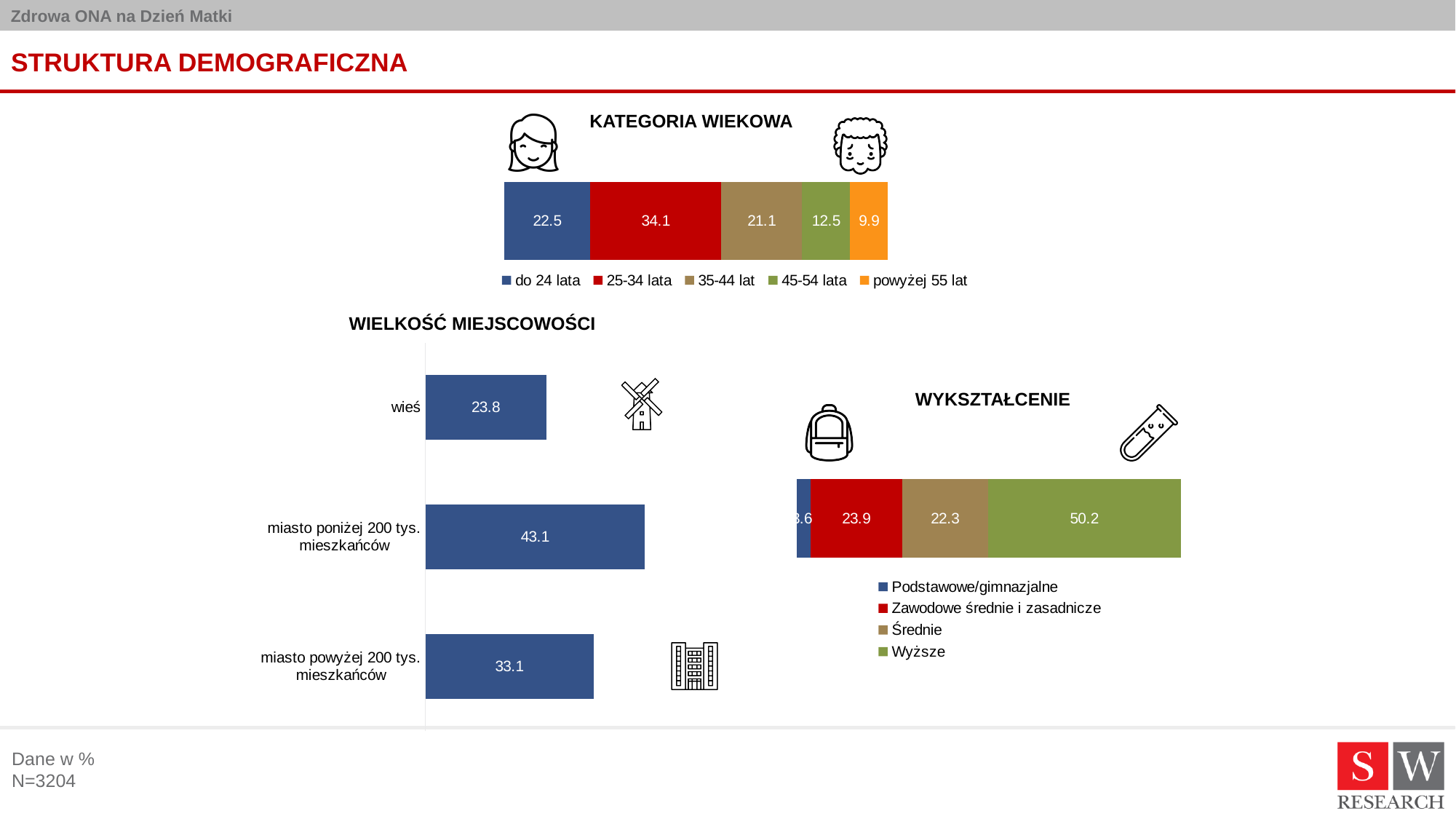
In the KATEGORIA WIEKOWA chart, what is the value for the 25-34 lata segment? 34.1 In the WIELKOŚĆ MIEJSCOWOŚCI chart, what is the difference between miasto poniżej 200 tys. mieszkańców and miasto powyżej 200 tys. mieszkańców? 10.0 In the WYKSZTAŁCENIE chart, what is the value for Wyższe? 50.2 In the WIELKOŚĆ MIEJSCOWOŚCI chart, which category has the highest value? miasto poniżej 200 tys. mieszkańców What kind of chart is the WIELKOŚĆ MIEJSCOWOŚCI chart? bar chart How many series does the legend of the KATEGORIA WIEKOWA chart list? 5 In the WYKSZTAŁCENIE chart, which is larger: Zawodowe średnie i zasadnicze or Średnie? Zawodowe średnie i zasadnicze In the KATEGORIA WIEKOWA chart, which age category has the highest value? 25-34 lata How many categories are shown in the WIELKOŚĆ MIEJSCOWOŚCI chart? 3 In the WIELKOŚĆ MIEJSCOWOŚCI chart, what is the value for wieś? 23.8 In the KATEGORIA WIEKOWA chart, what is the difference between the values for do 24 lata and 45-54 lata? 10.0 In the KATEGORIA WIEKOWA chart, which age category has the lowest value? powyżej 55 lat